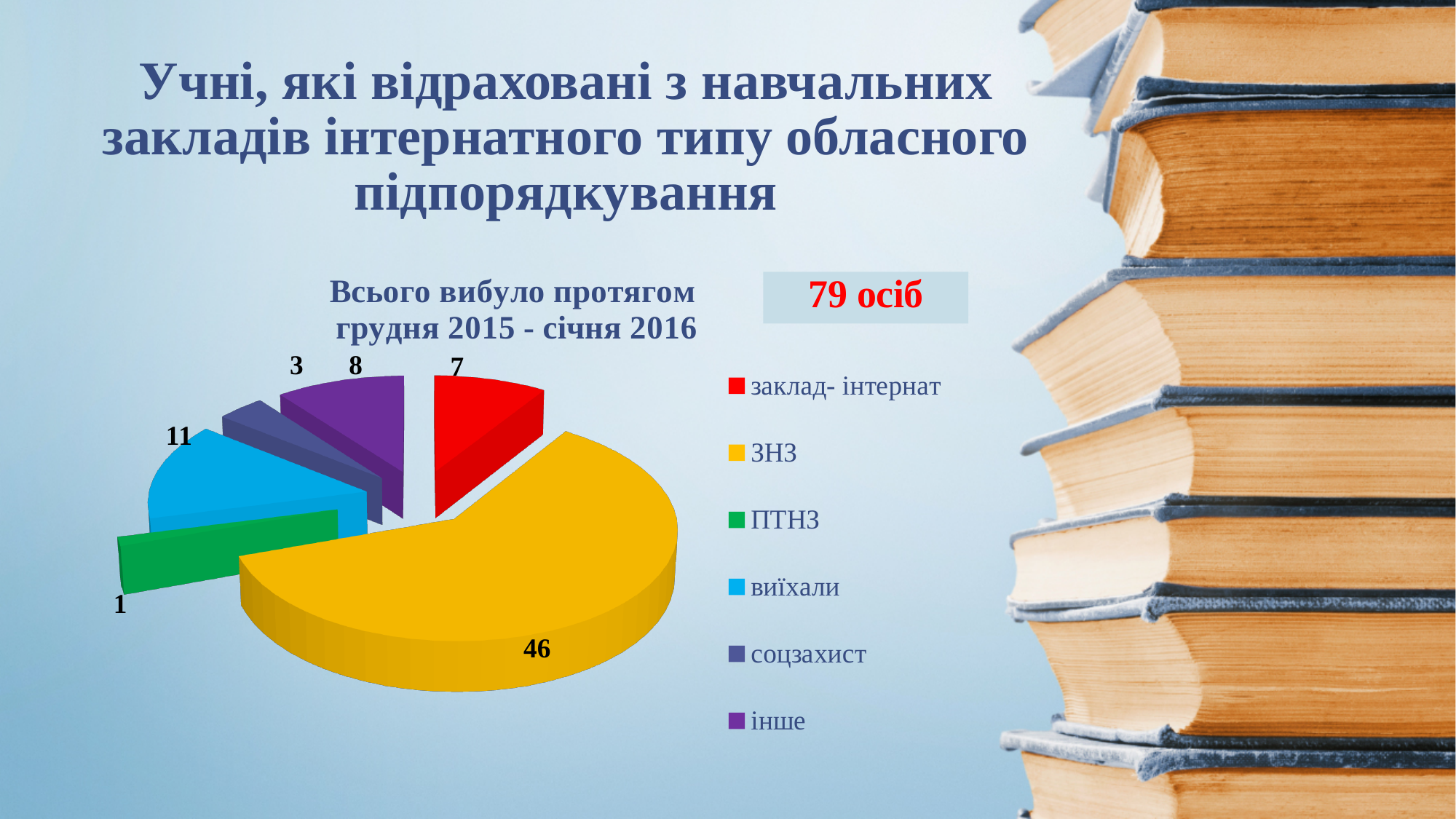
What colour is the slice for ЗНЗ in the pie chart? Yellow Which category has the smallest slice in the pie chart? ПТНЗ What is the value for виїхали in the pie chart? 11 Which is larger, the value for інше or the value for заклад- інтернат? інше What is the value for соцзахист in the pie chart? 3 What is the value for ЗНЗ in the pie chart? 46 What is the value for інше in the pie chart? 8 What is the value for заклад- інтернат in the pie chart? 7 Which category has the largest slice in the pie chart? ЗНЗ How many categories does the legend of the pie chart list? 6 What is the difference between the values for ЗНЗ and виїхали? 35 What type of chart is shown on the slide? Pie chart